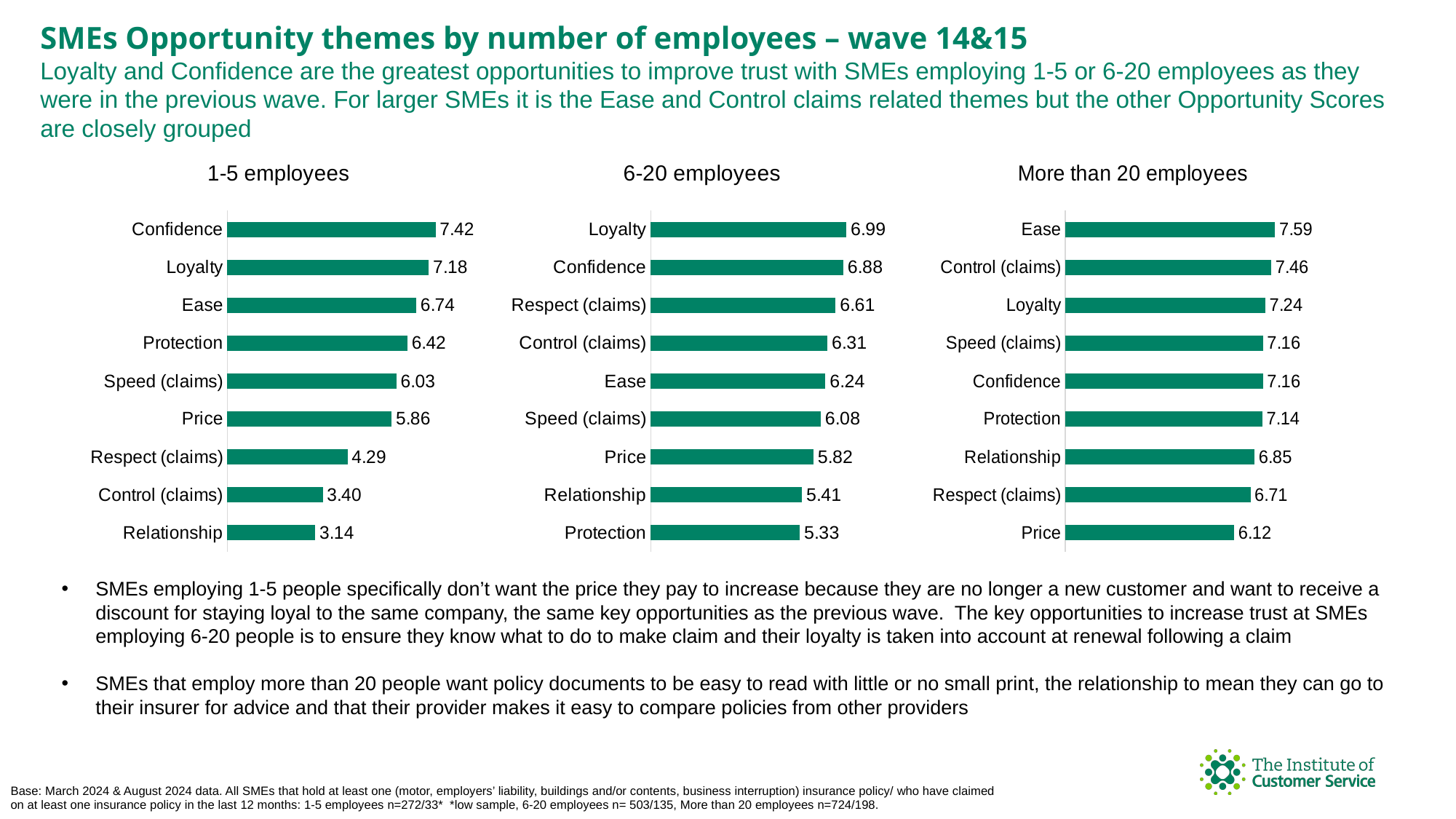
How many themes are shown in the '6-20 employees' chart? 9 In the 'More than 20 employees' chart, what is the value for Price? 6.12 In the '1-5 employees' chart, what is the difference between Confidence and Relationship? 4.28 How many charts are shown on the slide? 3 In the '6-20 employees' chart, what is the value for Respect (claims)? 6.61 In the '1-5 employees' chart, what is the value for Confidence? 7.42 In the '6-20 employees' chart, what is the difference between Loyalty and Protection? 1.66 What type of chart is the '1-5 employees' chart? Bar chart In the '6-20 employees' chart, which theme has the highest value? Loyalty In the 'More than 20 employees' chart, which is larger, Control (claims) or Relationship? Control (claims) In the '1-5 employees' chart, which theme has the lowest value? Relationship In the 'More than 20 employees' chart, which theme has the highest value? Ease